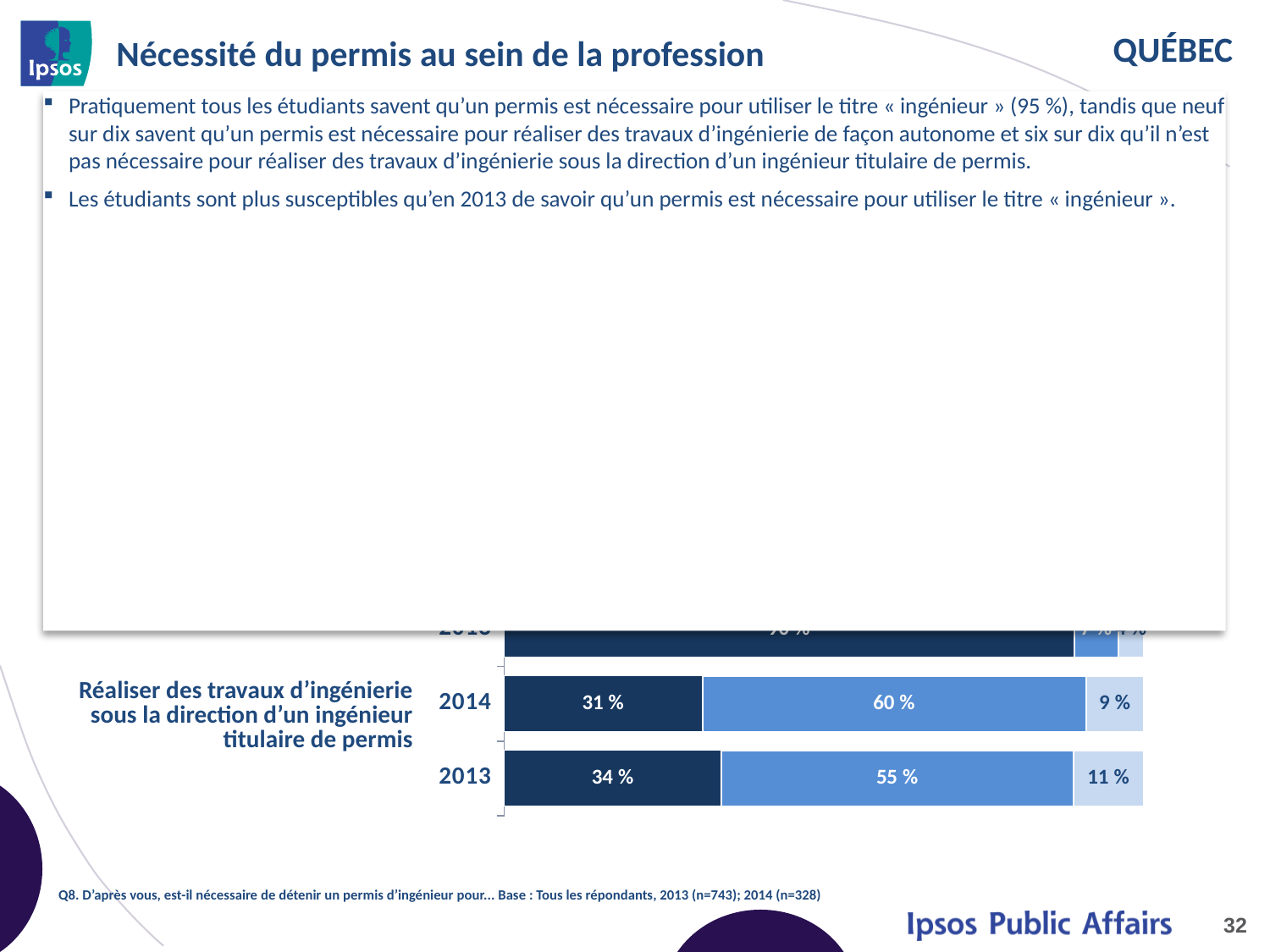
For 'Réaliser des travaux d'ingénierie sous la direction d'un ingénieur titulaire de permis', what is the difference between the dark navy segment in 2013 and in 2014? 3 % How many coloured segments make up each bar in the chart? 3 For 'Réaliser des travaux d'ingénierie sous la direction d'un ingénieur titulaire de permis', what is the total of the three segments of the 2014 bar? 100 % In the chart, for 'Réaliser des travaux d'ingénierie sous la direction d'un ingénieur titulaire de permis', what is the value of the light blue segment of the 2013 bar? 11 % For 'Réaliser des travaux d'ingénierie sous la direction d'un ingénieur titulaire de permis', which year has the larger dark navy segment, 2013 or 2014? 2013 In the chart, for 'Réaliser des travaux d'ingénierie sous la direction d'un ingénieur titulaire de permis', what is the value of the light blue segment of the 2014 bar? 9 % What kind of chart is shown on the slide? Stacked bar chart In the chart, for 'Réaliser des travaux d'ingénierie sous la direction d'un ingénieur titulaire de permis', what is the value of the medium blue segment of the 2013 bar? 55 % In the chart, for 'Réaliser des travaux d'ingénierie sous la direction d'un ingénieur titulaire de permis', what is the value of the medium blue segment of the 2014 bar? 60 % In the chart, for 'Réaliser des travaux d'ingénierie sous la direction d'un ingénieur titulaire de permis', what is the value of the dark navy segment of the 2013 bar? 34 % For 'Réaliser des travaux d'ingénierie sous la direction d'un ingénieur titulaire de permis', what is the difference between the medium blue segment in 2014 and in 2013? 5 % In the chart, for 'Réaliser des travaux d'ingénierie sous la direction d'un ingénieur titulaire de permis', what is the value of the dark navy segment of the 2014 bar? 31 %